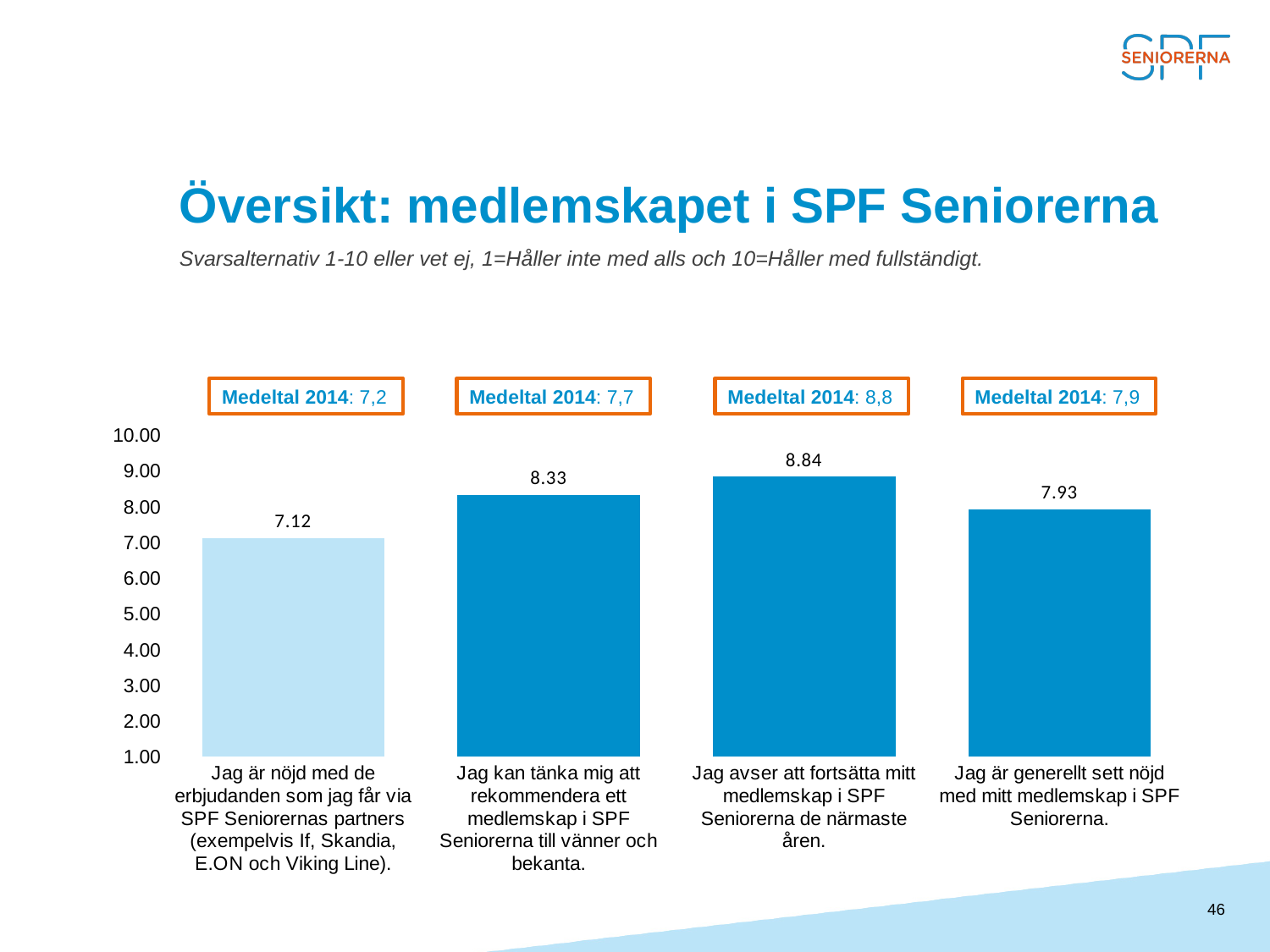
How many categories (bars) are shown in the chart? 4 What is the highest value shown on the y axis of the chart? 10.00 What is the "Medeltal 2014" value shown above the bar for "Jag avser att fortsätta mitt medlemskap i SPF Seniorerna de närmaste åren"? 8,8 What is the difference between the highest value (8.84) and the lowest value (7.12)? 1.72 What is the value for "Jag är nöjd med de erbjudanden som jag får via SPF Seniorernas partners"? 7.12 What is the value for "Jag kan tänka mig att rekommendera ett medlemskap i SPF Seniorerna till vänner och bekanta"? 8.33 What is the value for "Jag avser att fortsätta mitt medlemskap i SPF Seniorerna de närmaste åren"? 8.84 Which category has the lowest value? Jag är nöjd med de erbjudanden som jag får via SPF Seniorernas partners (exempelvis If, Skandia, E.ON och Viking Line). What is the value for "Jag är generellt sett nöjd med mitt medlemskap i SPF Seniorerna"? 7.93 Which is larger: the value for recommending a membership to friends (8.33) or the value for being generally satisfied with the membership (7.93)? Jag kan tänka mig att rekommendera ett medlemskap i SPF Seniorerna till vänner och bekanta (8.33) What kind of chart is shown on the slide? Bar chart Which category has the highest value? Jag avser att fortsätta mitt medlemskap i SPF Seniorerna de närmaste åren.